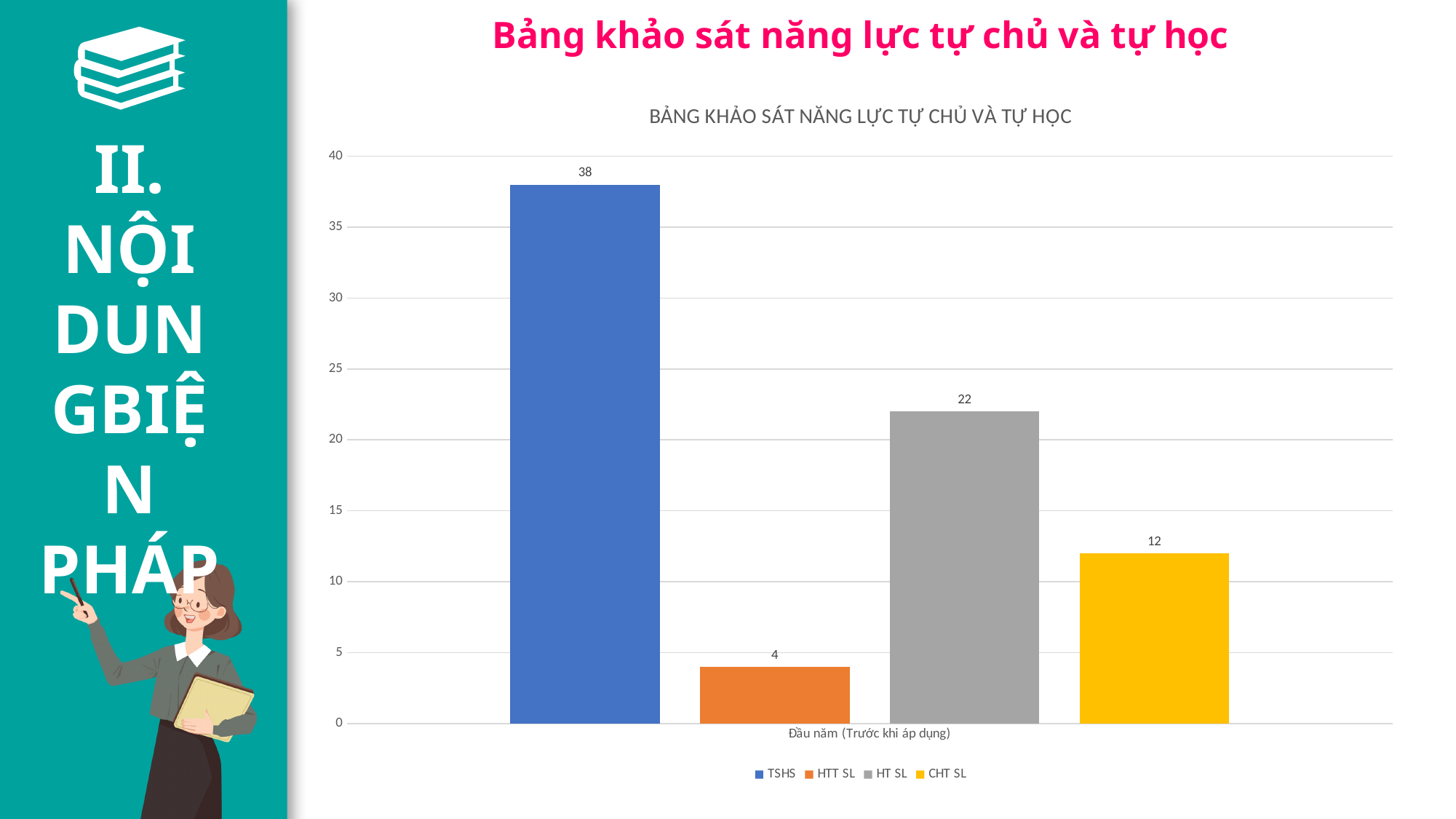
Which series has the highest value? TSHS What is the x-axis category label shown under the bars? Đầu năm (Trước khi áp dụng) How many series does the legend list? 4 What is the value for HTT SL? 4 Which series has the lowest value? HTT SL What is the value for HT SL? 22 What is the value for TSHS? 38 What is the difference between the values for TSHS and HT SL? 16 What kind of chart is shown? bar chart Is the value for CHT SL greater or less than 15? less What is the value for CHT SL? 12 Which is larger, the value for HT SL or the value for CHT SL? HT SL